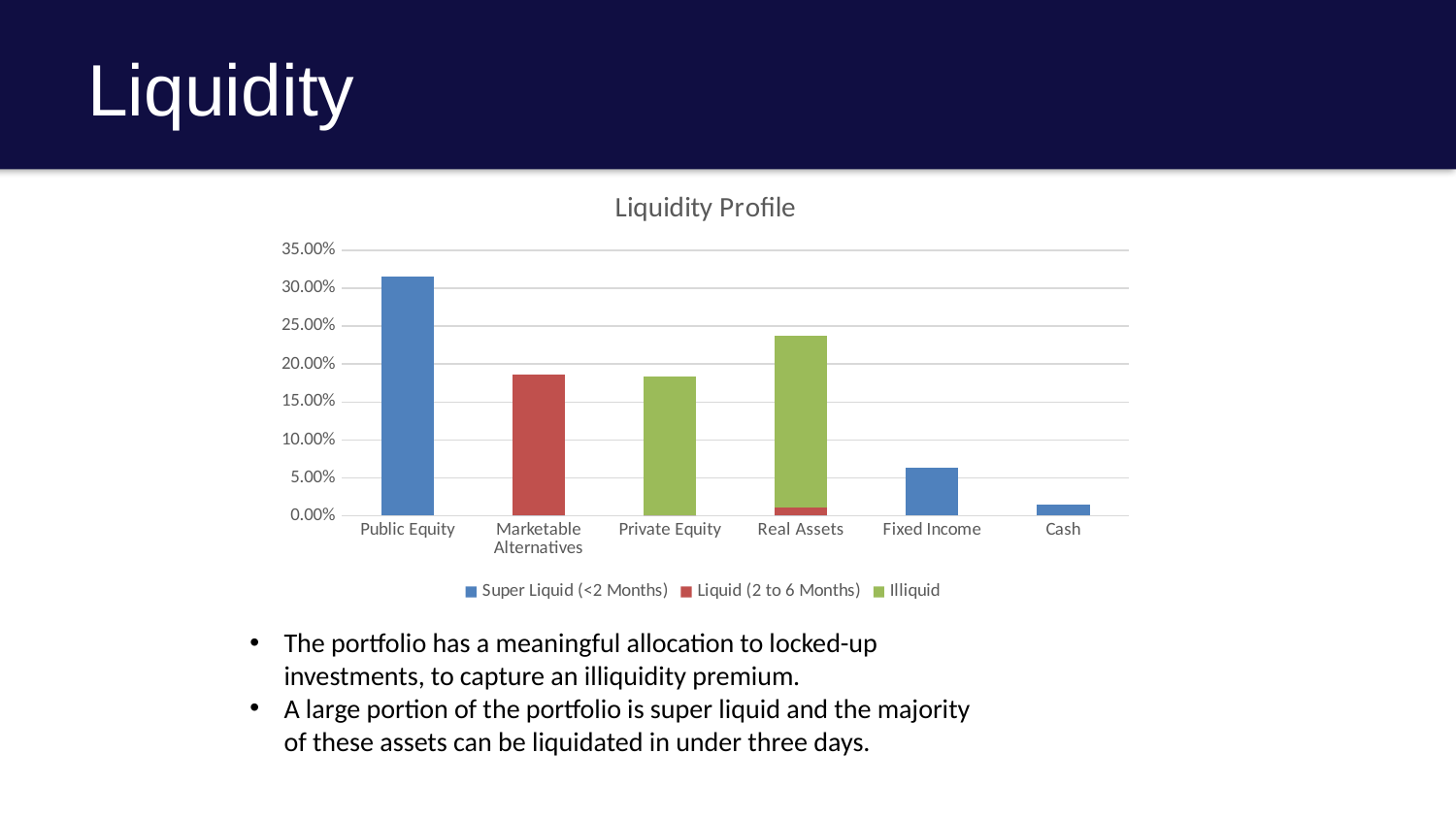
What kind of chart is shown on the slide? Bar chart Which is larger, the bar for Real Assets or the bar for Fixed Income? Real Assets Which category has the tallest bar in the chart? Public Equity Is the value for Fixed Income greater or less than 10.00%? less What is the title of the chart? Liquidity Profile Is the value for Public Equity greater or less than 30.00%? greater Is the total bar for Real Assets greater or less than 20.00%? greater How many categories are shown on the x axis of the chart? 6 Which legend series is shown in green in the chart? Illiquid Which is larger, the bar for Public Equity or the bar for Real Assets? Public Equity How many series does the chart's legend list? 3 Which category has the shortest bar in the chart? Cash